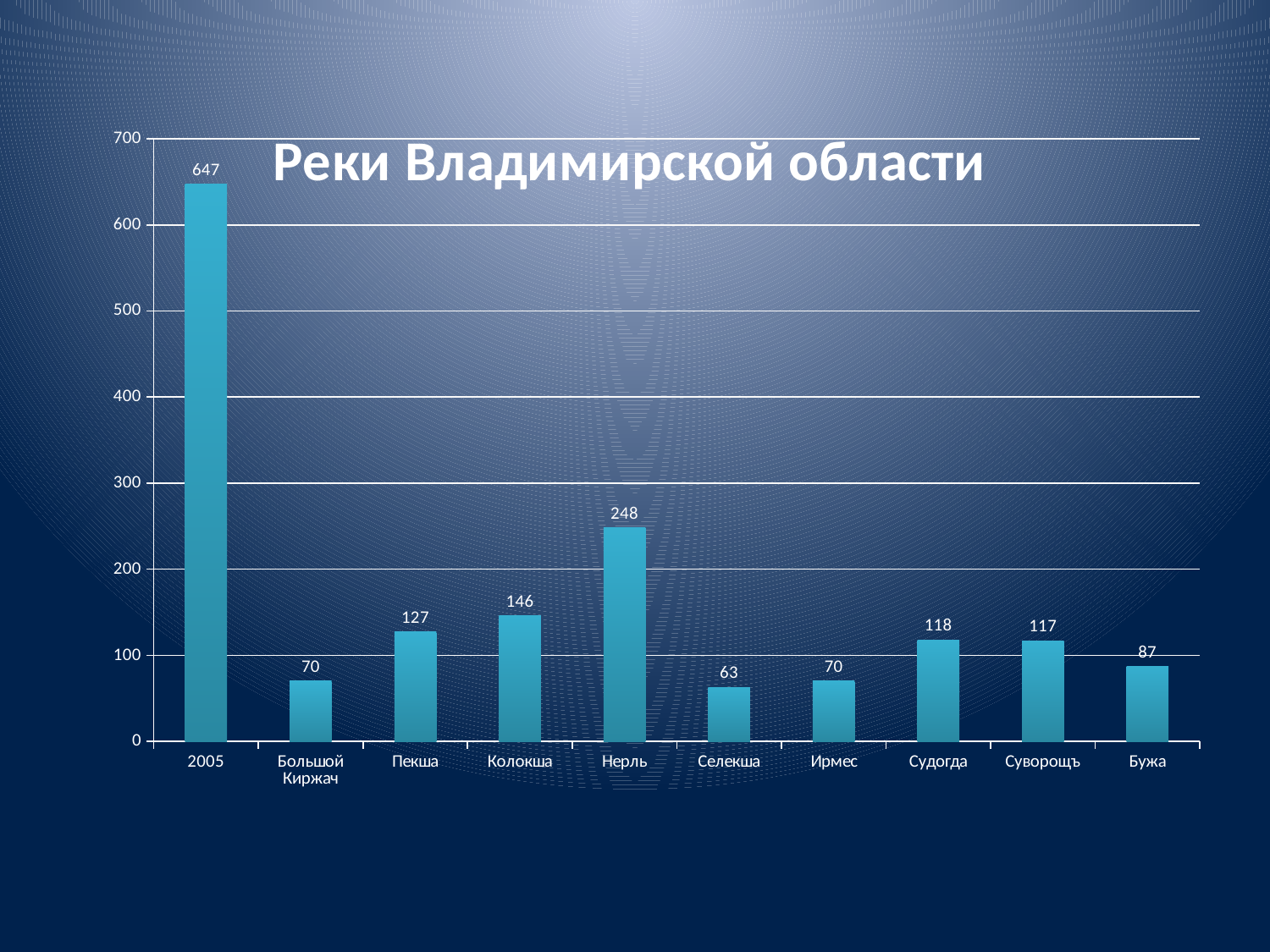
Which category has the highest value? 2005 Which category has the lowest value? Селекша What is the value for Нерль? 248 Is the value for Нерль greater or less than 200? greater What is the value for Бужа? 87 Which is larger, the value for Колокша or the value for Пекша? Колокша What is the title of the chart? Реки Владимирской области What is the value for Колокша? 146 What kind of chart is shown on the slide? bar chart What is the value for Судогда? 118 How many categories are shown on the x axis? 10 What is the difference between the values for Нерль and Пекша? 121